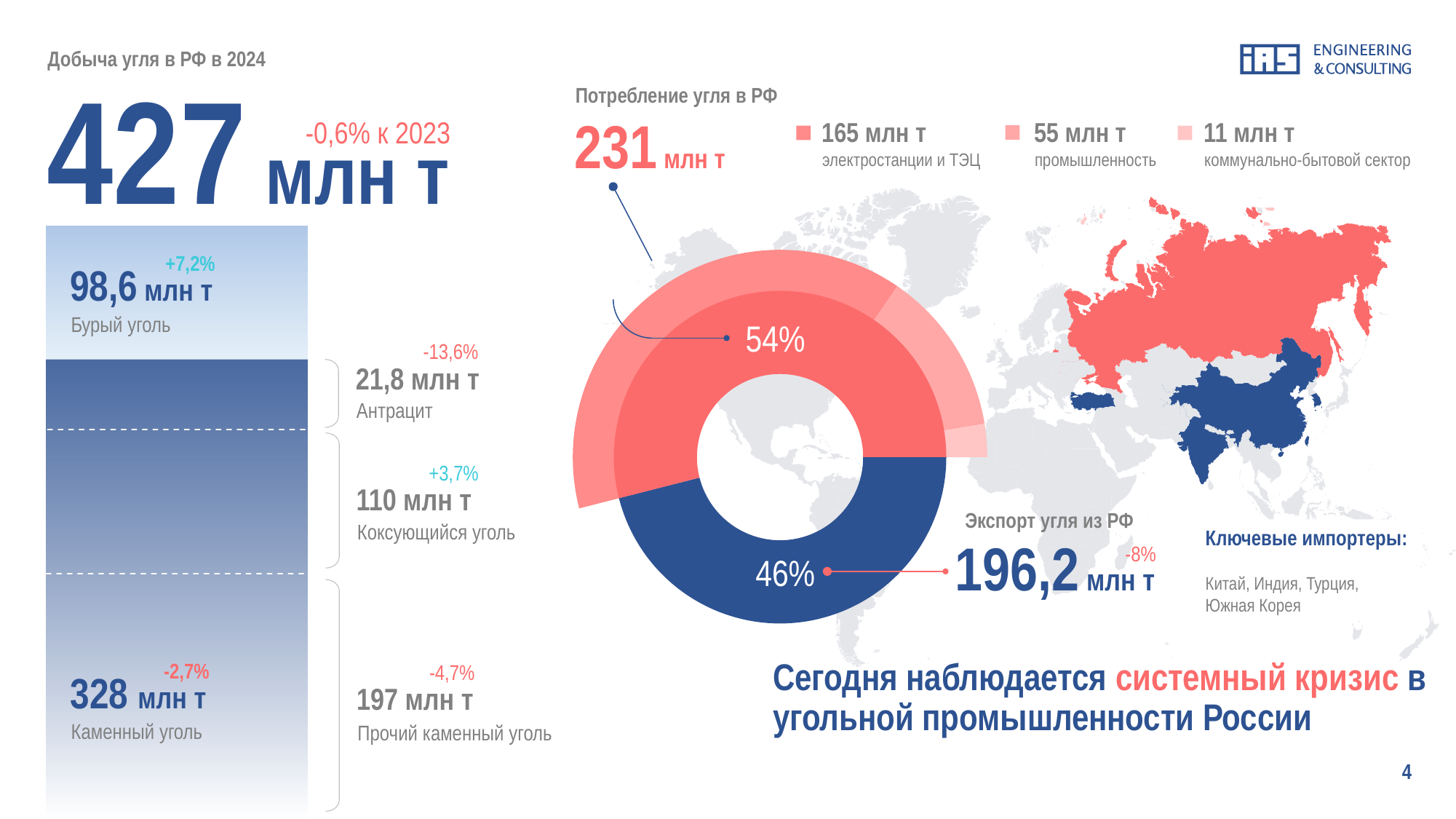
In the stacked bar on the left (Добыча угля в РФ в 2024), what is the value for Бурый уголь? 98,6 млн т In the donut chart, which is larger: the share for consumption or the share for export? Consumption (54%) What kind of chart is the chart in the centre of the slide showing 54% and 46%? Pie (donut) chart In the stacked bar on the left, what is the difference between Каменный уголь and Бурый уголь? 229,4 млн т In the stacked bar on the left, what is the value for Антрацит? 21,8 млн т In the donut chart, what share of coal is shown for export from Russia (Экспорт угля из РФ)? 46% In the consumption legend above the donut chart, which category has the highest value? электростанции и ТЭЦ (165 млн т) In the stacked bar on the left, what is the value for Каменный уголь? 328 млн т In the stacked bar on the left, what is the value for Коксующийся уголь? 110 млн т In the stacked bar on the left, what is the value for Прочий каменный уголь? 197 млн т In the donut chart, what share of coal is shown for consumption in Russia (Потребление угля в РФ)? 54% What is the total of the stacked bar on the left (Бурый уголь plus Каменный уголь)? 426,6 млн т